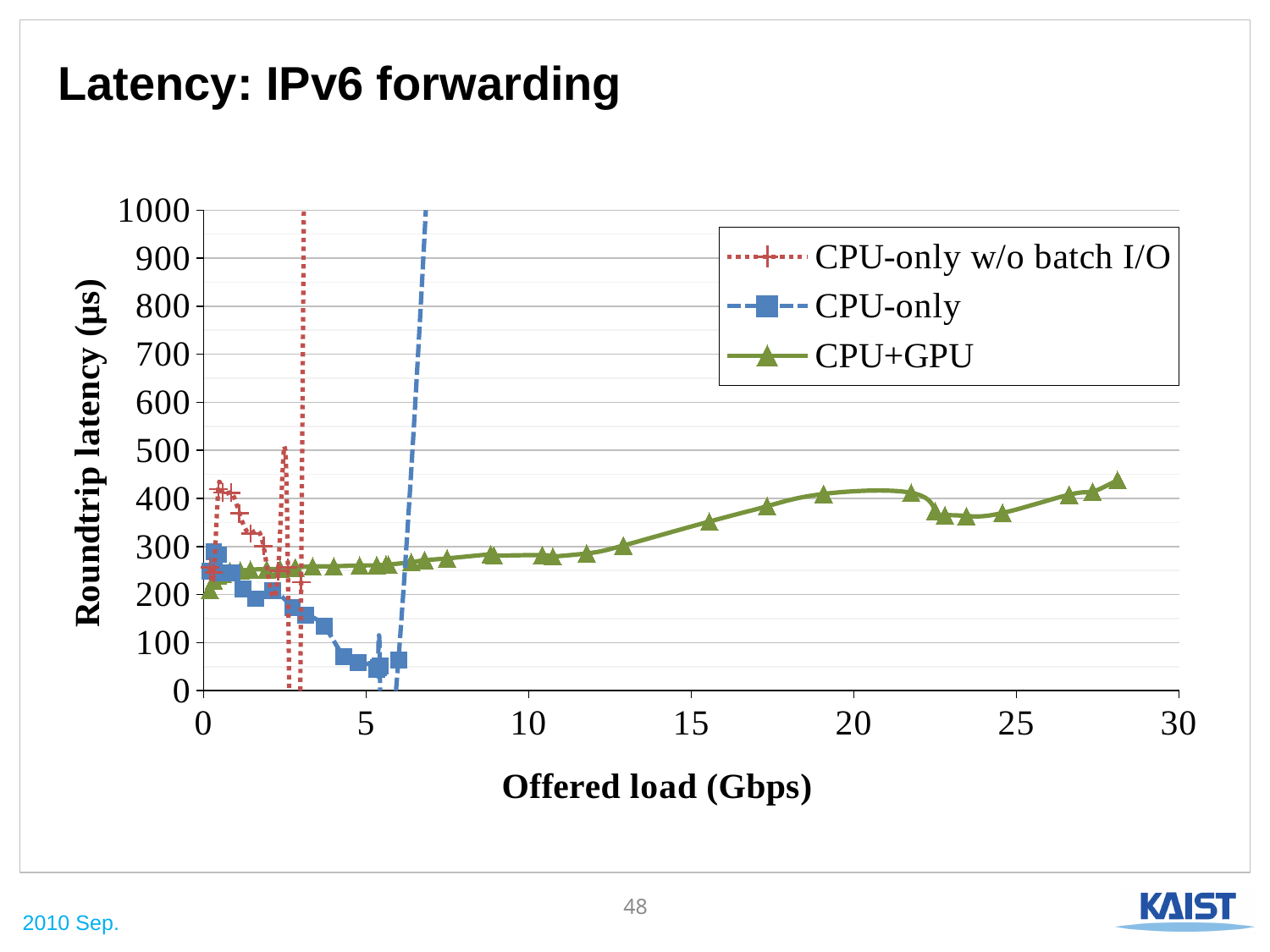
What kind of chart is shown on the slide? line chart Which series shoots up to 1000 µs at the lowest offered load? CPU-only w/o batch I/O What are the three series named in the legend? CPU-only w/o batch I/O, CPU-only, CPU+GPU Is the CPU-only roundtrip latency at about 5 Gbps offered load greater or less than 100 µs? less Which series extends to the highest offered load on the chart? CPU+GPU Is the CPU+GPU roundtrip latency at 10 Gbps offered load greater or less than 300 µs? less Does the CPU-only latency rise or fall as offered load increases from 0 to 5 Gbps? fall How many series does the legend list? 3 At about 1 Gbps offered load, which has the higher latency: CPU-only w/o batch I/O or CPU+GPU? CPU-only w/o batch I/O Does the CPU+GPU latency rise or fall as offered load increases from 10 to 20 Gbps? rise Is the CPU+GPU roundtrip latency at the highest plotted offered load (about 28 Gbps) greater or less than 400 µs? greater What is the title of the x axis? Offered load (Gbps)